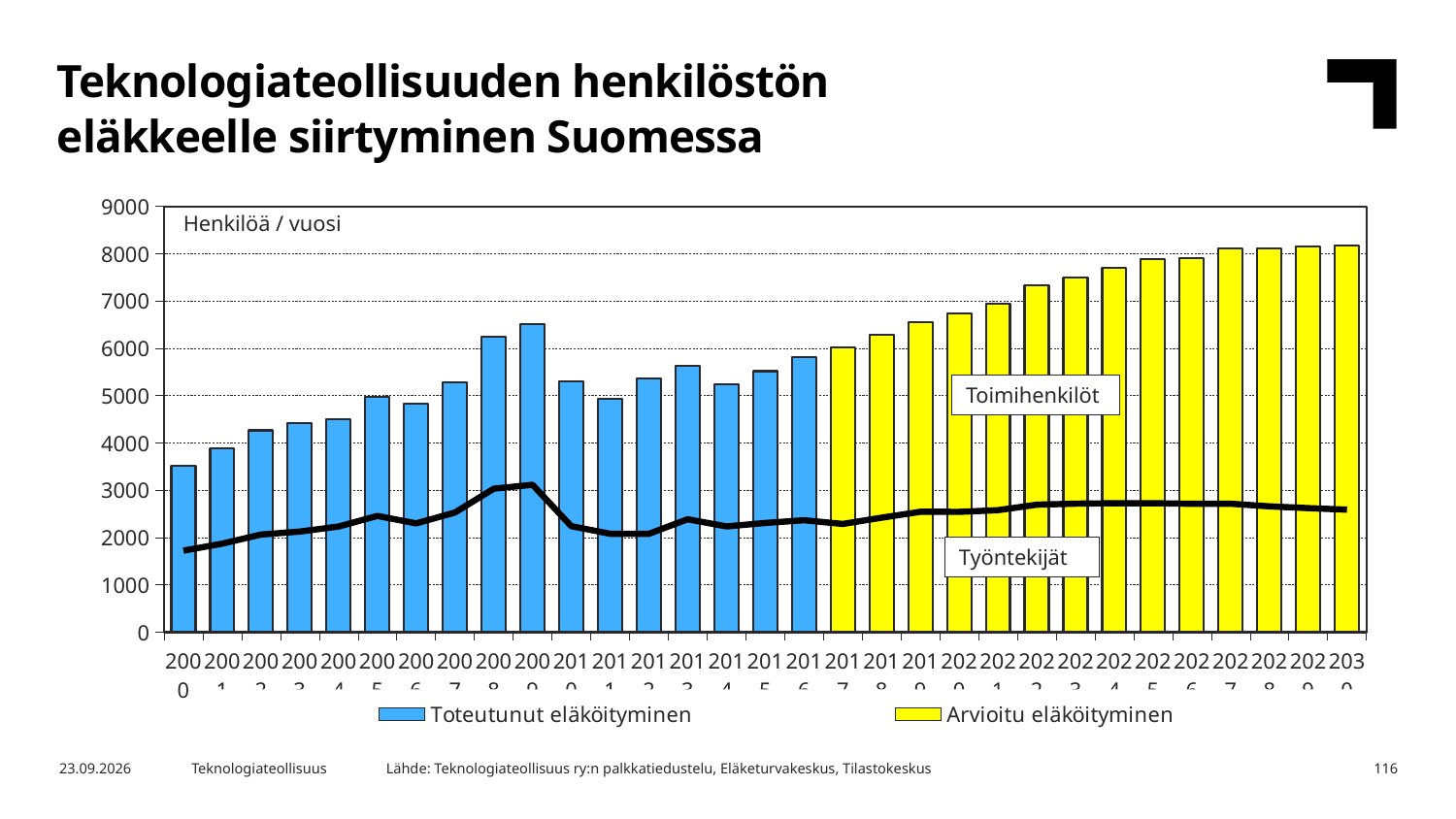
Do the yellow bars (Arvioitu eläköityminen) rise or fall from 2017 to 2030? rise Among the blue bars (Toteutunut eläköityminen), which year has the highest value? 2009 What unit label is shown at the top left inside the plot area? Henkilöä / vuosi Is the value for 2016 greater or less than 6000? less How many series does the legend list? 2 Is the value for 2030 greater or less than 8000? greater Is the value for 2009 greater or less than 6000? greater Which year has the lowest bar? 2000 How many years (bars) are plotted along the x axis? 31 Which is larger, the value for 2009 or the value for 2010? 2009 What kind of chart is shown on the slide? combination bar and line chart